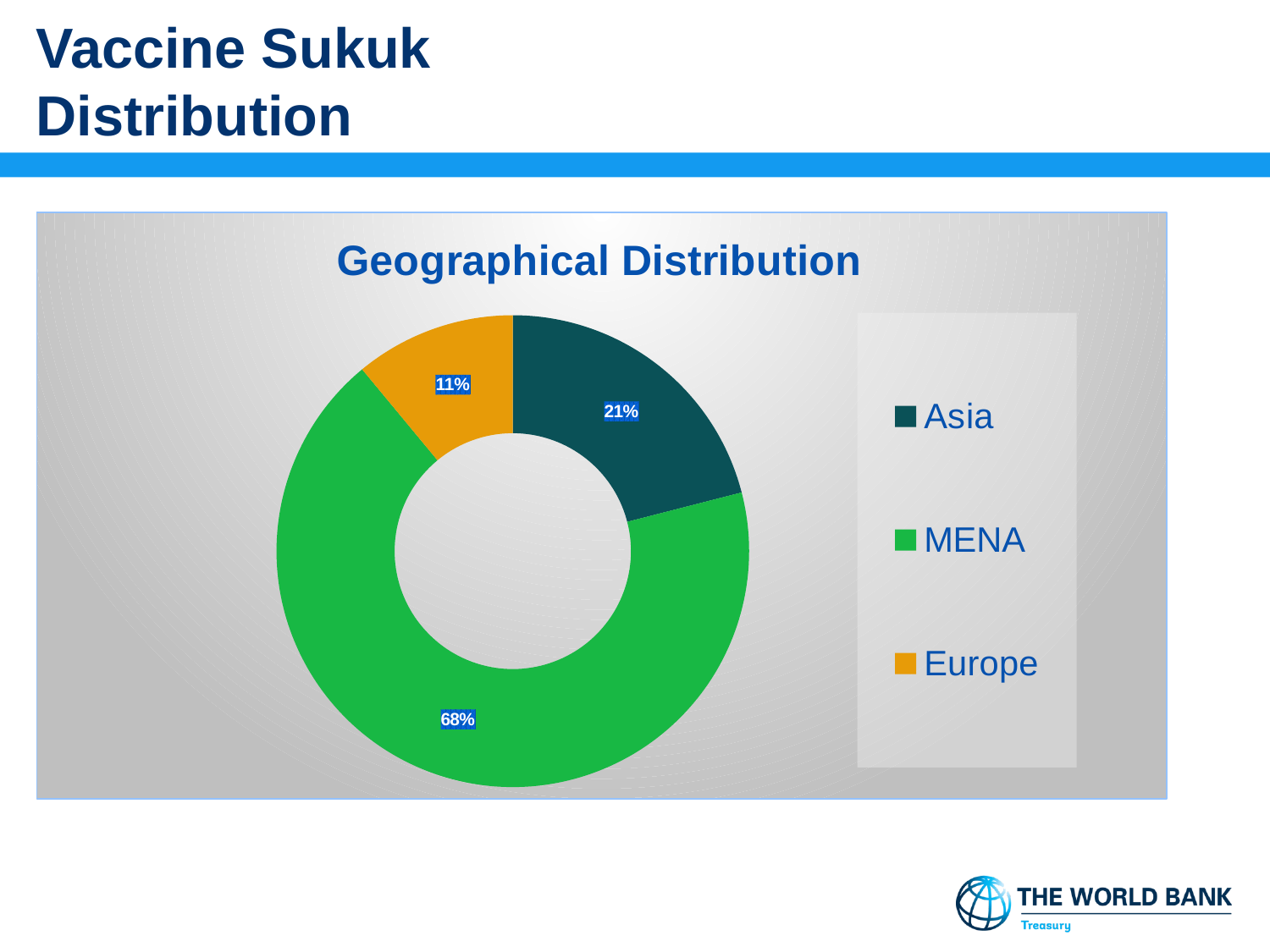
Which region has the largest share in the Geographical Distribution chart? MENA How many regions are shown in the Geographical Distribution chart? 3 What is the title of the chart on the slide? Geographical Distribution Which colour represents Europe in the chart? Orange Which region has the smallest share in the Geographical Distribution chart? Europe What is the difference in percentage points between the Asia and Europe shares? 10 What share of the Geographical Distribution chart does Asia account for? 21% What kind of chart is used to show the Geographical Distribution? Doughnut (pie) chart What is the difference in percentage points between the MENA and Asia shares? 47 What share of the Geographical Distribution chart does Europe account for? 11% What share of the Geographical Distribution chart does MENA account for? 68% Which has a larger share, Asia or Europe? Asia